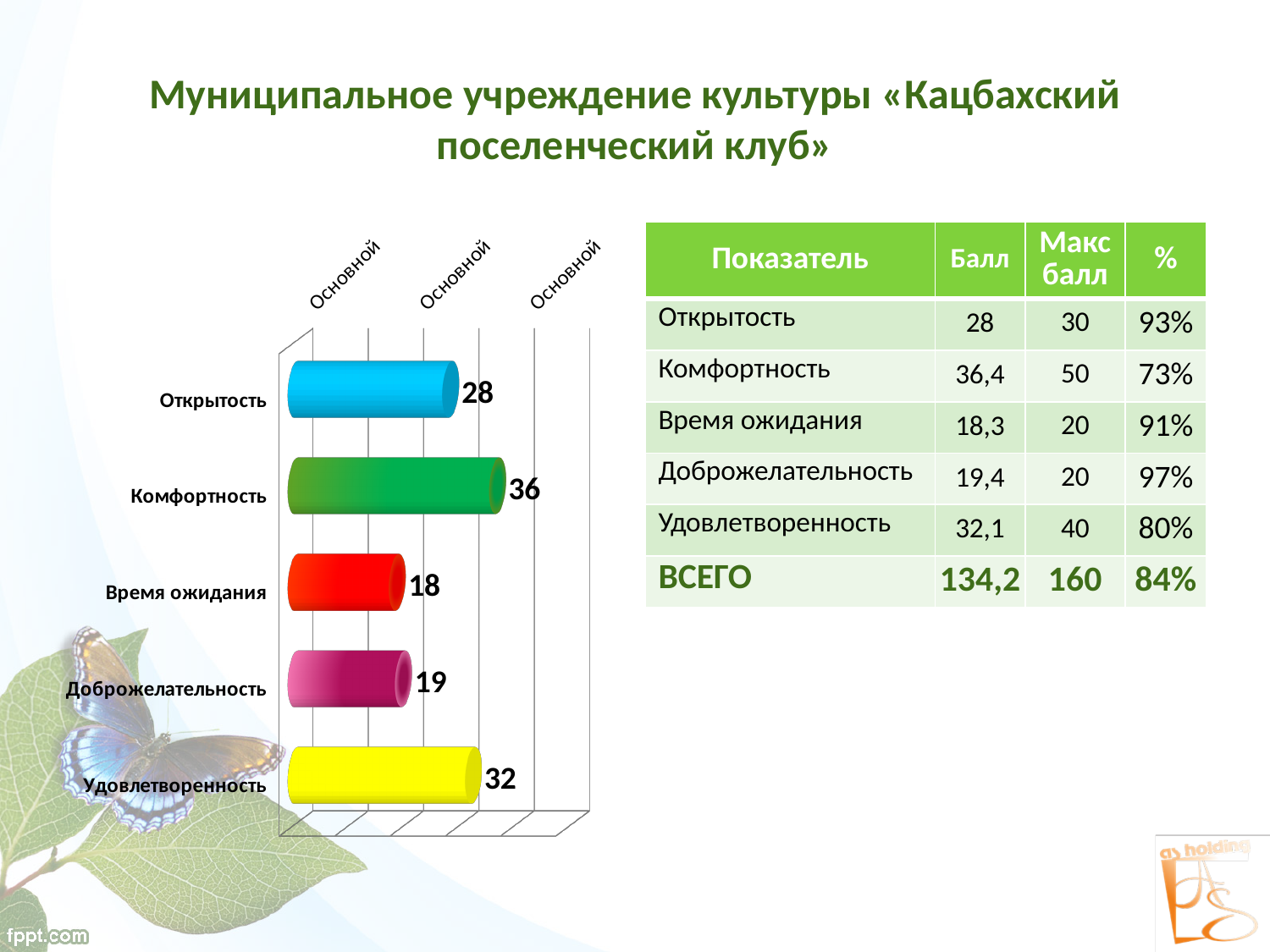
How many categories does the bar chart show? 5 Which category has the lowest value in the bar chart? Время ожидания What is the value for Удовлетворенность in the bar chart? 32 Which category has the highest value in the bar chart? Комфортность What colour is the bar for Время ожидания in the bar chart? Red What is the value for Открытость in the bar chart? 28 Which is larger in the bar chart, the value for Удовлетворенность or the value for Открытость? Удовлетворенность What kind of chart is shown on the slide? Bar chart What is the value for Время ожидания in the bar chart? 18 What is the difference between the values for Комфортность and Открытость in the bar chart? 8 What is the value for Доброжелательность in the bar chart? 19 What is the value for Комфортность in the bar chart? 36